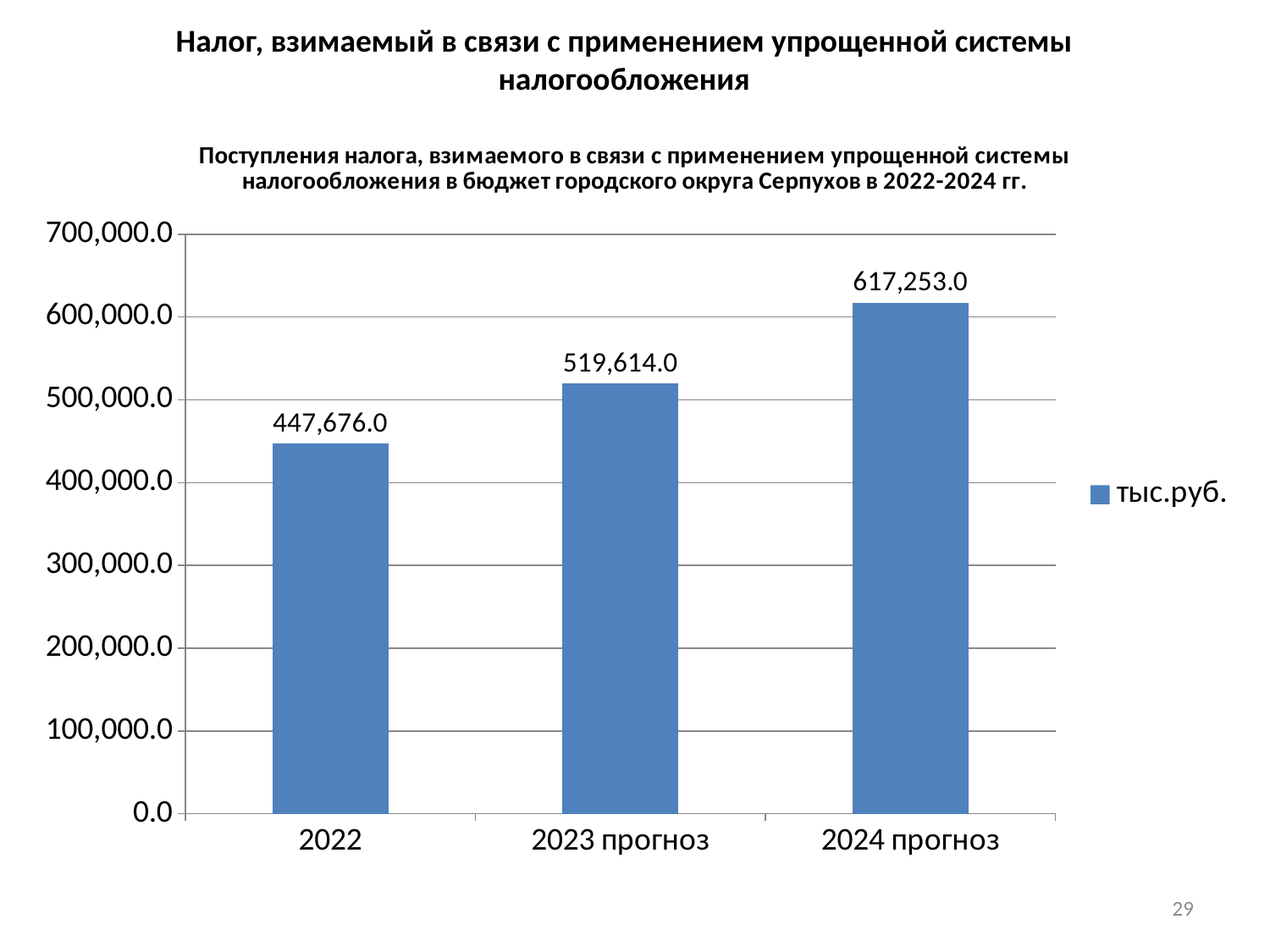
Which category has the highest value? 2024 прогноз What is the difference between the values for 2024 прогноз and 2023 прогноз? 97,639.0 Which category has the lowest value? 2022 Which is larger, the value for 2022 or the value for 2023 прогноз? 2023 прогноз What is the value for 2024 прогноз? 617,253.0 What kind of chart is shown on the slide? bar chart What is the value for 2022? 447,676.0 What is the difference between the values for 2023 прогноз and 2022? 71,938.0 How many categories are shown on the x axis? 3 Is the value for 2024 прогноз greater or less than 600,000.0? greater What is the value for 2023 прогноз? 519,614.0 Do the values rise or fall from 2022 to 2024 прогноз? rise